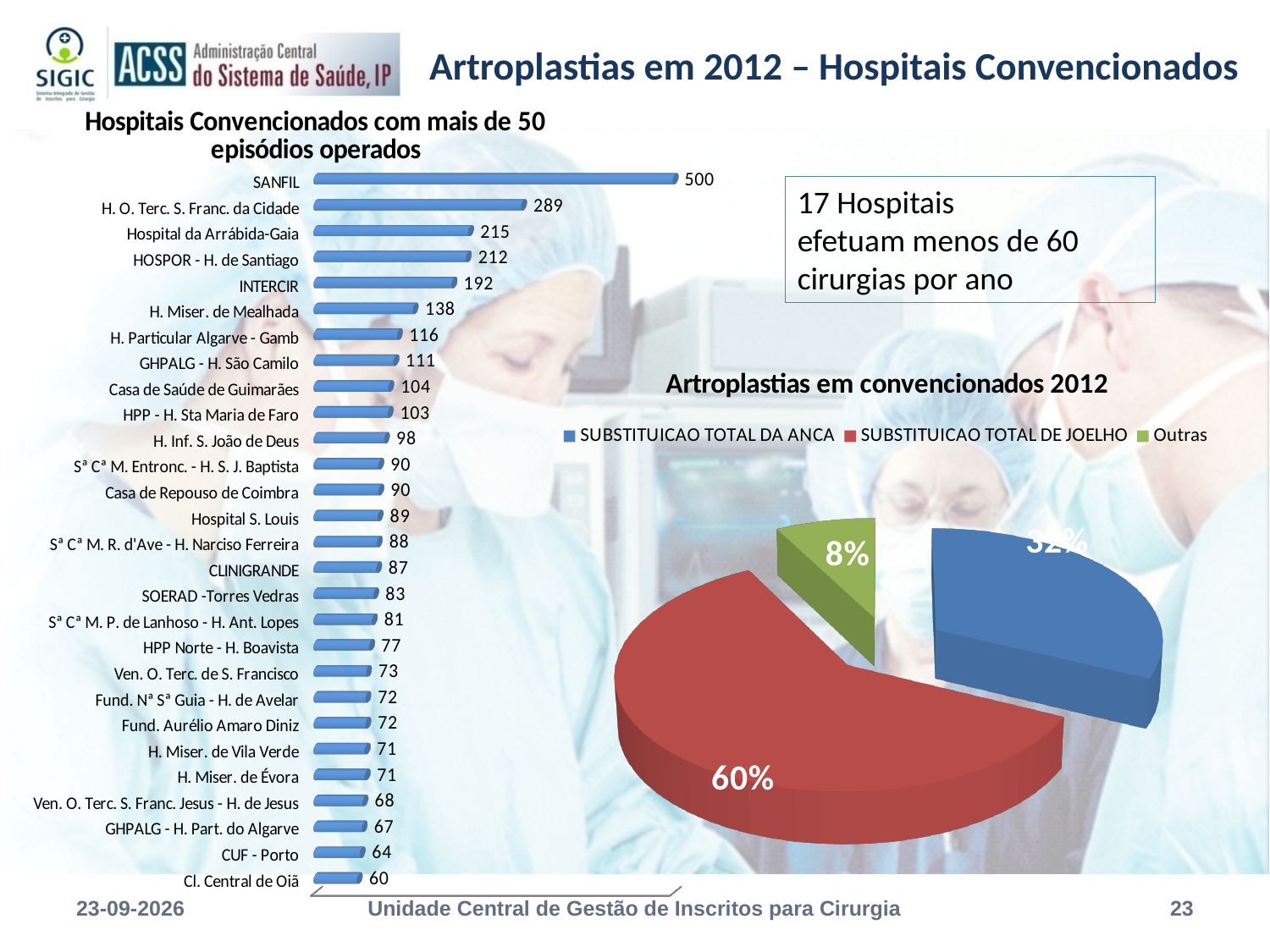
In the pie chart 'Artroplastias em convencionados 2012', what share is SUBSTITUICAO TOTAL DE JOELHO? 60% In the pie chart 'Artroplastias em convencionados 2012', what share is Outras? 8% What kind of chart is 'Hospitais Convencionados com mais de 50 episódios operados'? Bar chart In the bar chart 'Hospitais Convencionados com mais de 50 episódios operados', what is the value for SANFIL? 500 In the bar chart 'Hospitais Convencionados com mais de 50 episódios operados', what is the difference between SANFIL and H. O. Terc. S. Franc. da Cidade? 211 In the bar chart 'Hospitais Convencionados com mais de 50 episódios operados', which hospital has the lowest value? Cl. Central de Oiã In the bar chart 'Hospitais Convencionados com mais de 50 episódios operados', what is the value for CUF - Porto? 64 In the bar chart 'Hospitais Convencionados com mais de 50 episódios operados', which hospital has the highest value? SANFIL How many entries does the legend of the pie chart 'Artroplastias em convencionados 2012' list? 3 In the bar chart 'Hospitais Convencionados com mais de 50 episódios operados', what is the value for INTERCIR? 192 How many hospitals are shown in the bar chart 'Hospitais Convencionados com mais de 50 episódios operados'? 28 In the bar chart 'Hospitais Convencionados com mais de 50 episódios operados', which is larger: Hospital da Arrábida-Gaia or H. Miser. de Mealhada? Hospital da Arrábida-Gaia